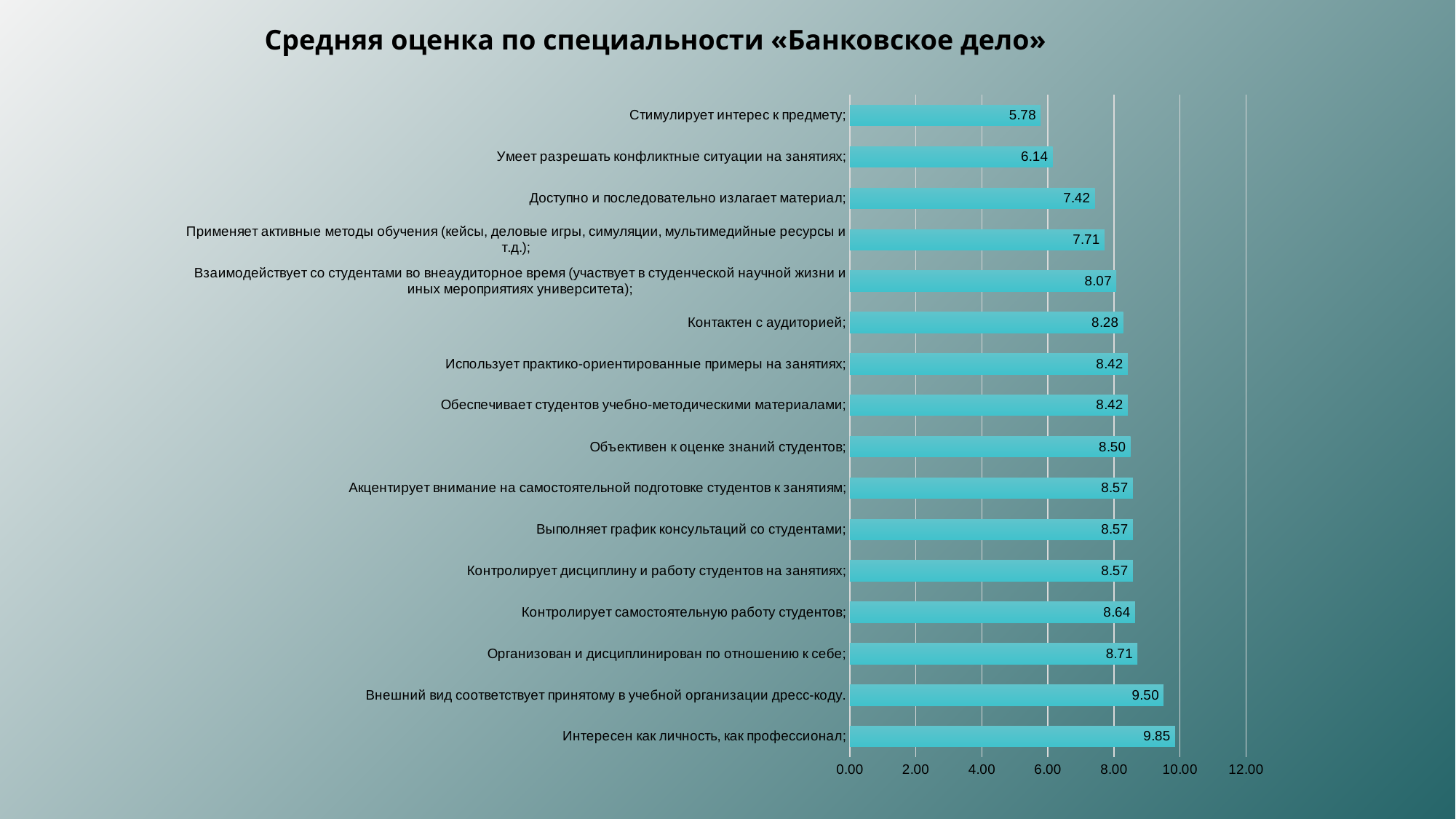
How many categories are plotted in the chart? 16 Which category has the lowest value? Стимулирует интерес к предмету What is the title of the chart? Средняя оценка по специальности «Банковское дело» What is the value for «Контактен с аудиторией»? 8.28 What is the value for «Внешний вид соответствует принятому в учебной организации дресс-коду»? 9.50 Which is larger: the value for «Доступно и последовательно излагает материал» or the value for «Умеет разрешать конфликтные ситуации на занятиях»? Доступно и последовательно излагает материал Which category has the highest value? Интересен как личность, как профессионал What is the value for «Стимулирует интерес к предмету»? 5.78 What is the difference between the values for «Внешний вид соответствует принятому в учебной организации дресс-коду» and «Организован и дисциплинирован по отношению к себе»? 0.79 What is the difference between the values for «Интересен как личность, как профессионал» and «Стимулирует интерес к предмету»? 4.07 What type of chart is shown on the slide? bar chart Is the value for «Организован и дисциплинирован по отношению к себе» greater or less than 8.00? greater